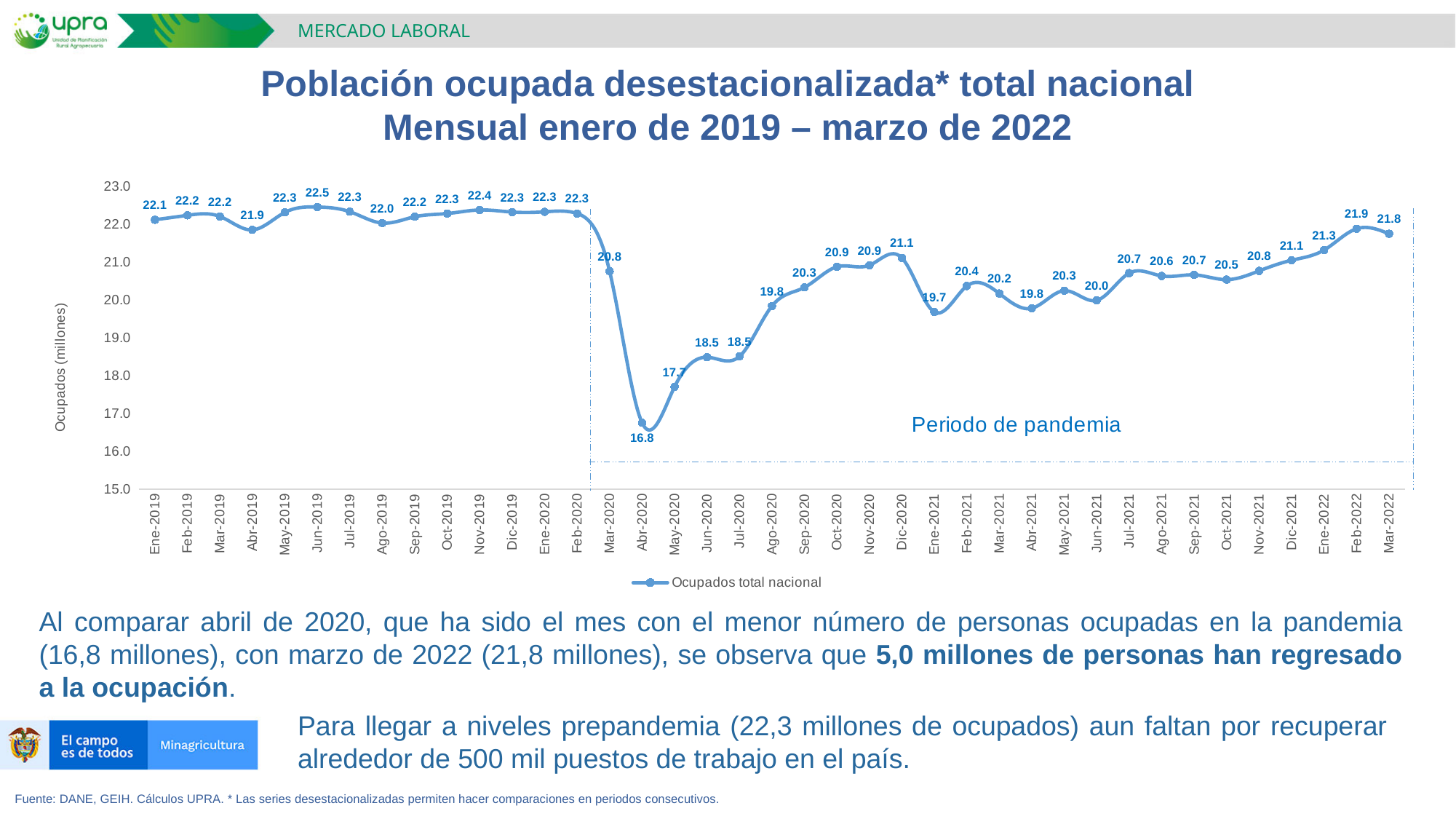
How many series does the legend list? 1 What is the value for Abr-2020? 16.8 What is the difference between the values for Mar-2022 and Abr-2020? 5.0 What kind of chart is shown on the slide? line chart What is the value for Jun-2019? 22.5 Do the values rise or fall from Abr-2020 to Dic-2020? rise What is the value for Mar-2022? 21.8 Which month has the lowest value in the chart? Abr-2020 How many monthly data points are plotted in the chart? 39 Which is larger, the value for Feb-2020 or the value for Mar-2020? Feb-2020 Which month has the highest value in the chart? Jun-2019 Is the value for May-2020 greater or less than 18.0? less